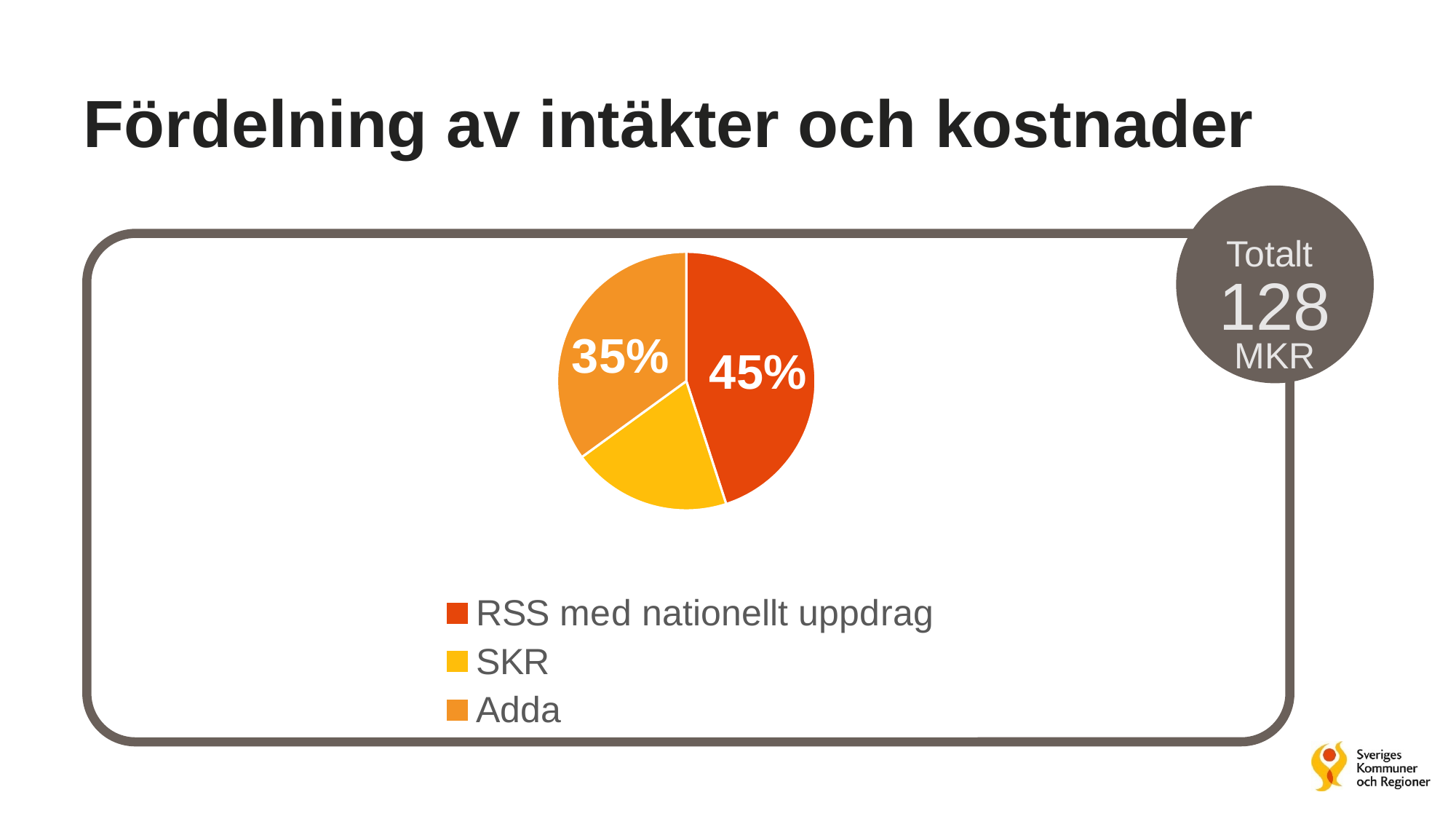
How many entries does the legend list? 3 What kind of chart is shown on the slide? Pie chart What share of the pie does RSS med nationellt uppdrag represent? 45% What total amount is shown in the circle next to the chart? 128 MKR What is the difference in percentage points between the RSS med nationellt uppdrag slice and the Adda slice? 10 percentage points Which category has the smallest slice of the pie? SKR Which is larger, the slice for SKR or the slice for Adda? Adda Which is larger, the slice for RSS med nationellt uppdrag or the slice for Adda? RSS med nationellt uppdrag What share of the pie does Adda represent? 35% How many slices does the pie chart have? 3 Which category has the largest slice of the pie? RSS med nationellt uppdrag What is the title of the slide? Fördelning av intäkter och kostnader